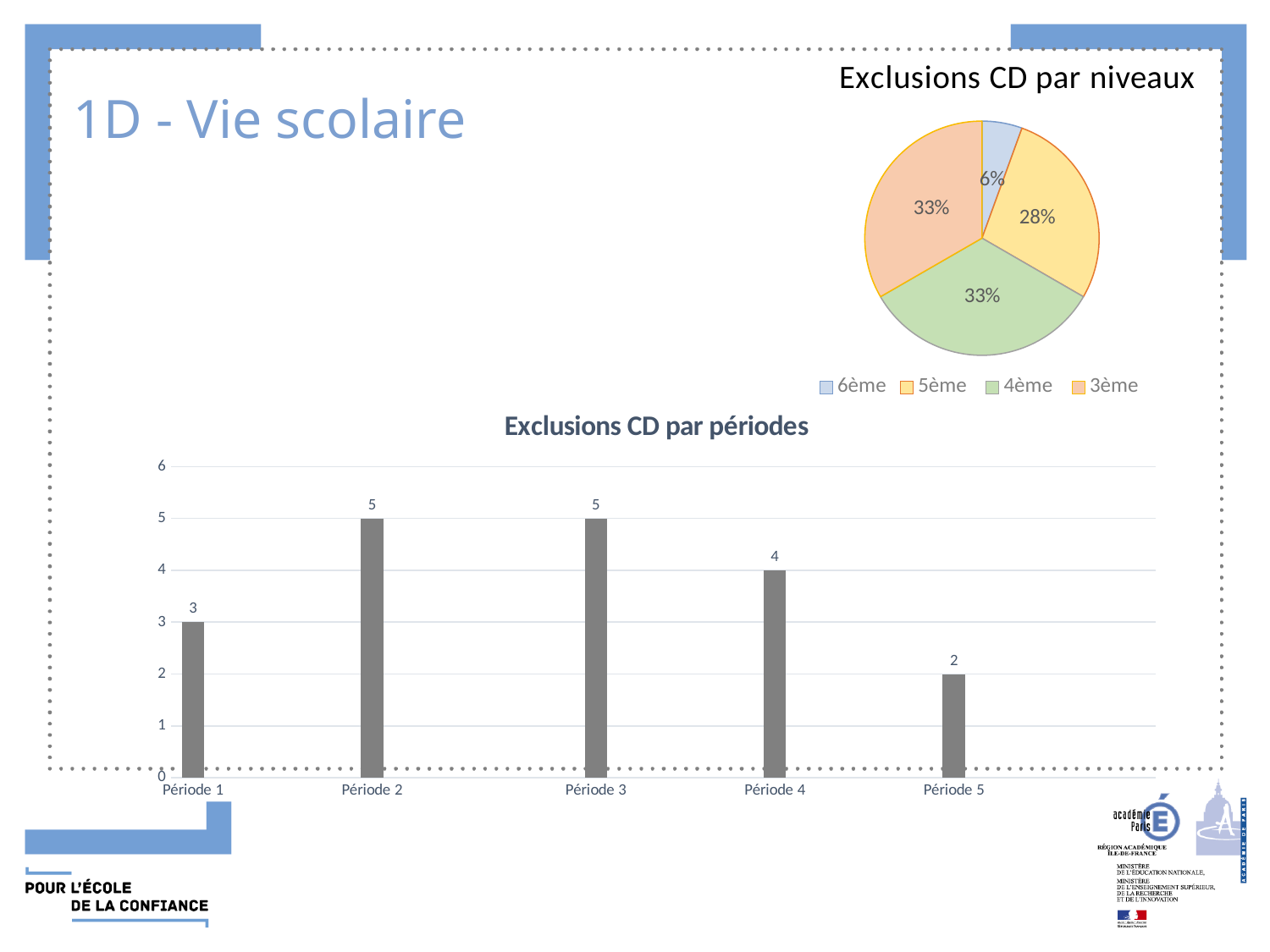
In the 'Exclusions CD par niveaux' pie chart, which level has the smallest share? 6ème In the 'Exclusions CD par périodes' chart, what is the difference between the values for Période 3 and Période 1? 2 In the 'Exclusions CD par périodes' chart, which is larger, the value for Période 4 or the value for Période 5? Période 4 In the 'Exclusions CD par niveaux' pie chart, what share does 5ème have? 28% What kind of chart is 'Exclusions CD par niveaux'? Pie chart In the 'Exclusions CD par périodes' chart, which period has the lowest value? Période 5 What kind of chart is 'Exclusions CD par périodes'? Bar chart In the 'Exclusions CD par périodes' chart, do the values rise or fall from Période 3 to Période 5? Fall In the 'Exclusions CD par périodes' chart, what is the value for Période 5? 2 In the 'Exclusions CD par périodes' chart, what is the value for Période 2? 5 How many periods are shown in the 'Exclusions CD par périodes' chart? 5 How many entries does the legend of the 'Exclusions CD par niveaux' pie chart list? 4